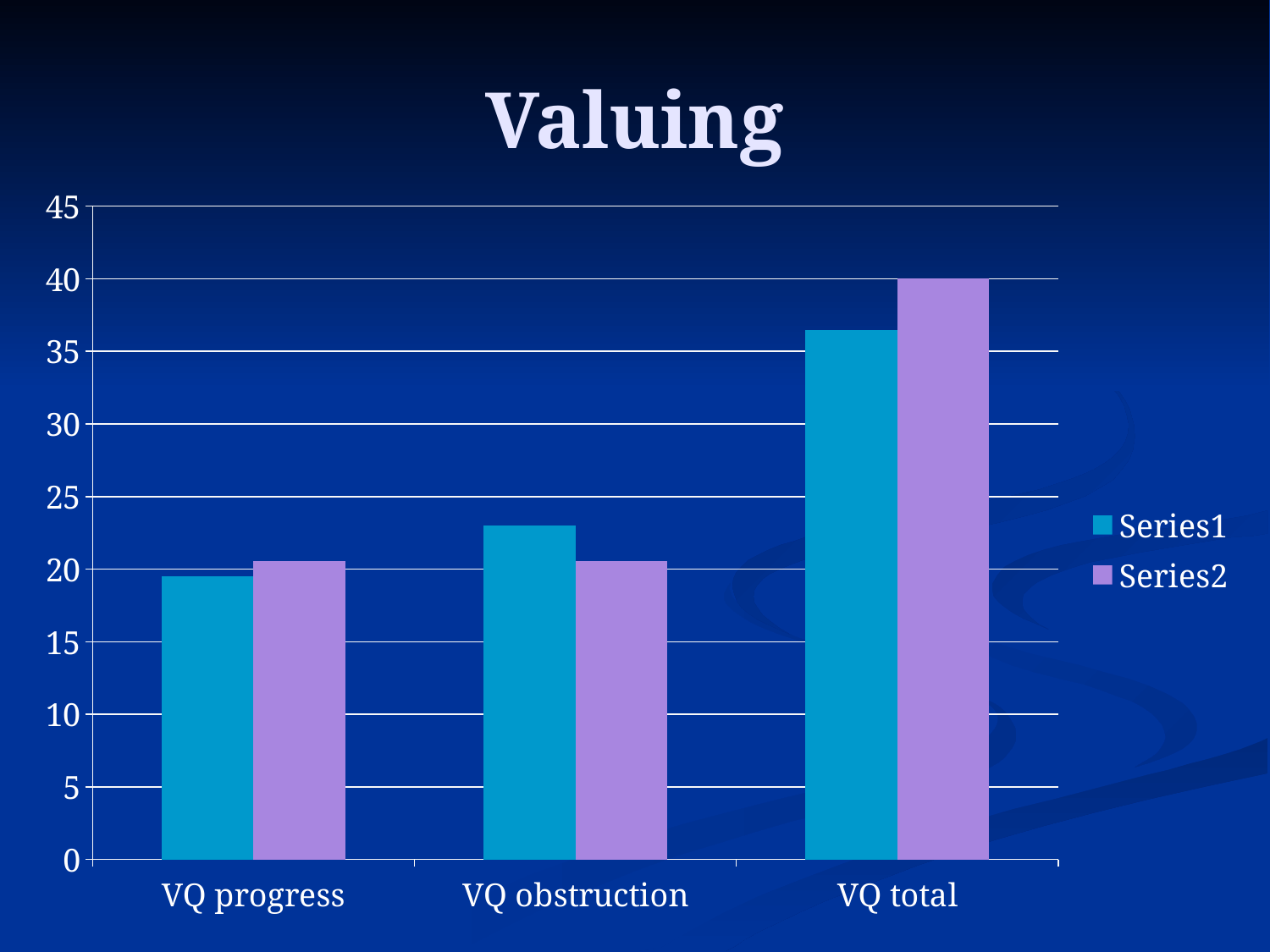
How many categories are shown on the x axis? 3 Which category has the highest value for Series1? VQ total Do the Series1 values rise or fall from VQ progress to VQ total along the x axis? rise For VQ obstruction, which series has the larger value, Series1 or Series2? Series1 What kind of chart is shown on the slide? bar chart How many series does the legend list? 2 Is the Series1 value for VQ total greater or less than 35? greater Which category has the lowest value for Series1? VQ progress Is the Series1 value for VQ obstruction greater or less than 25? less What is the title of the chart? Valuing Which category has the highest value for Series2? VQ total For VQ total, which series has the larger value, Series1 or Series2? Series2